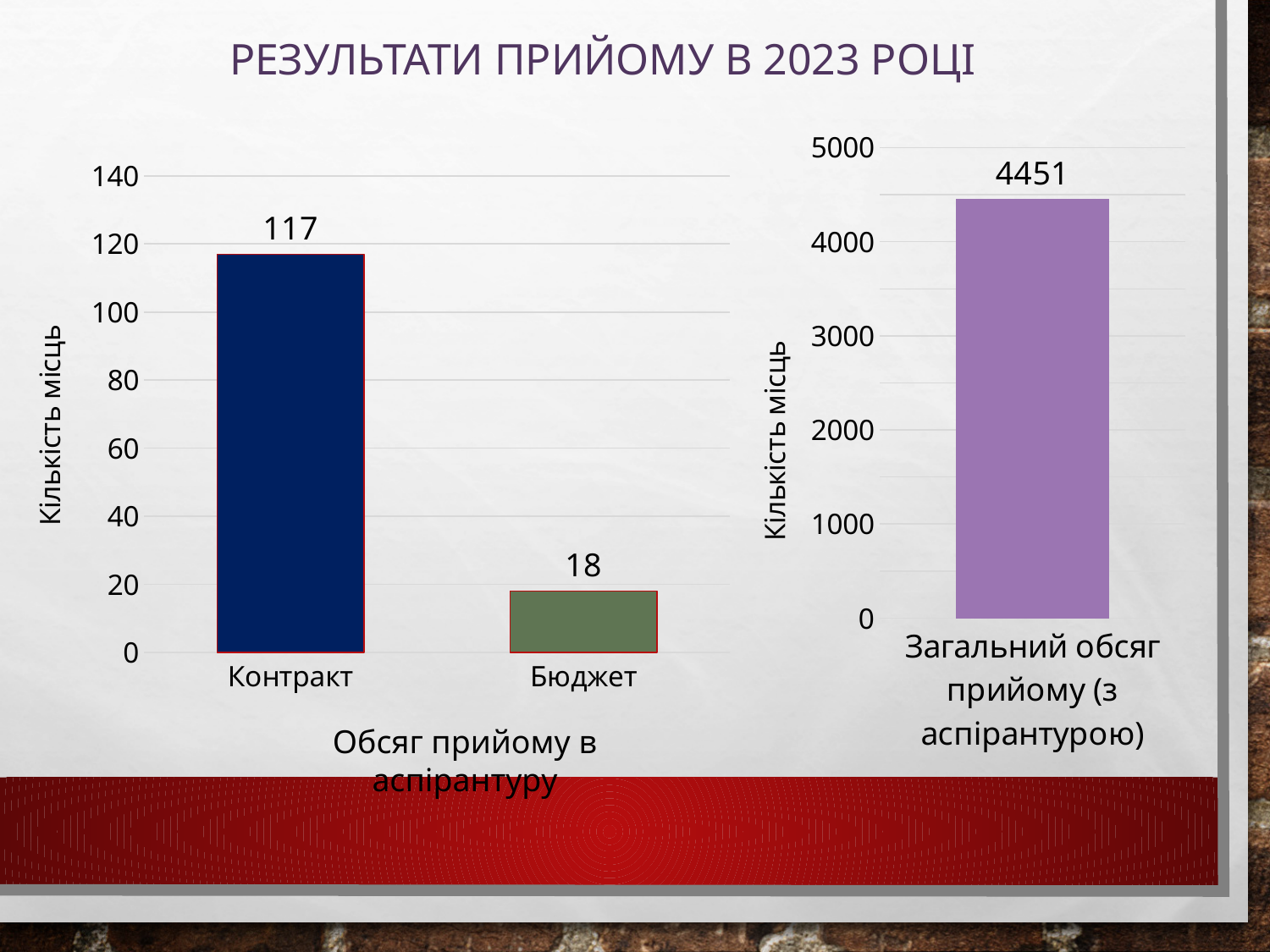
What is the title of the slide? Результати прийому в 2023 році In the right chart, what is the value for Загальний обсяг прийому (з аспірантурою)? 4451 What kind of chart is the right chart? bar chart In the left chart (Обсяг прийому в аспірантуру), how many categories are shown? 2 In the left chart (Обсяг прийому в аспірантуру), what is the value for Контракт? 117 In the right chart, is the value for Загальний обсяг прийому (з аспірантурою) greater or less than 4000? greater In the left chart (Обсяг прийому в аспірантуру), which category has the highest value? Контракт What is the y-axis label of the left chart (Обсяг прийому в аспірантуру)? Кількість місць In the left chart (Обсяг прийому в аспірантуру), what is the difference between the values for Контракт and Бюджет? 99 In the left chart (Обсяг прийому в аспірантуру), what is the value for Бюджет? 18 In the left chart (Обсяг прийому в аспірантуру), is the value for Контракт greater or less than 100? greater In the left chart (Обсяг прийому в аспірантуру), which category has the lowest value? Бюджет